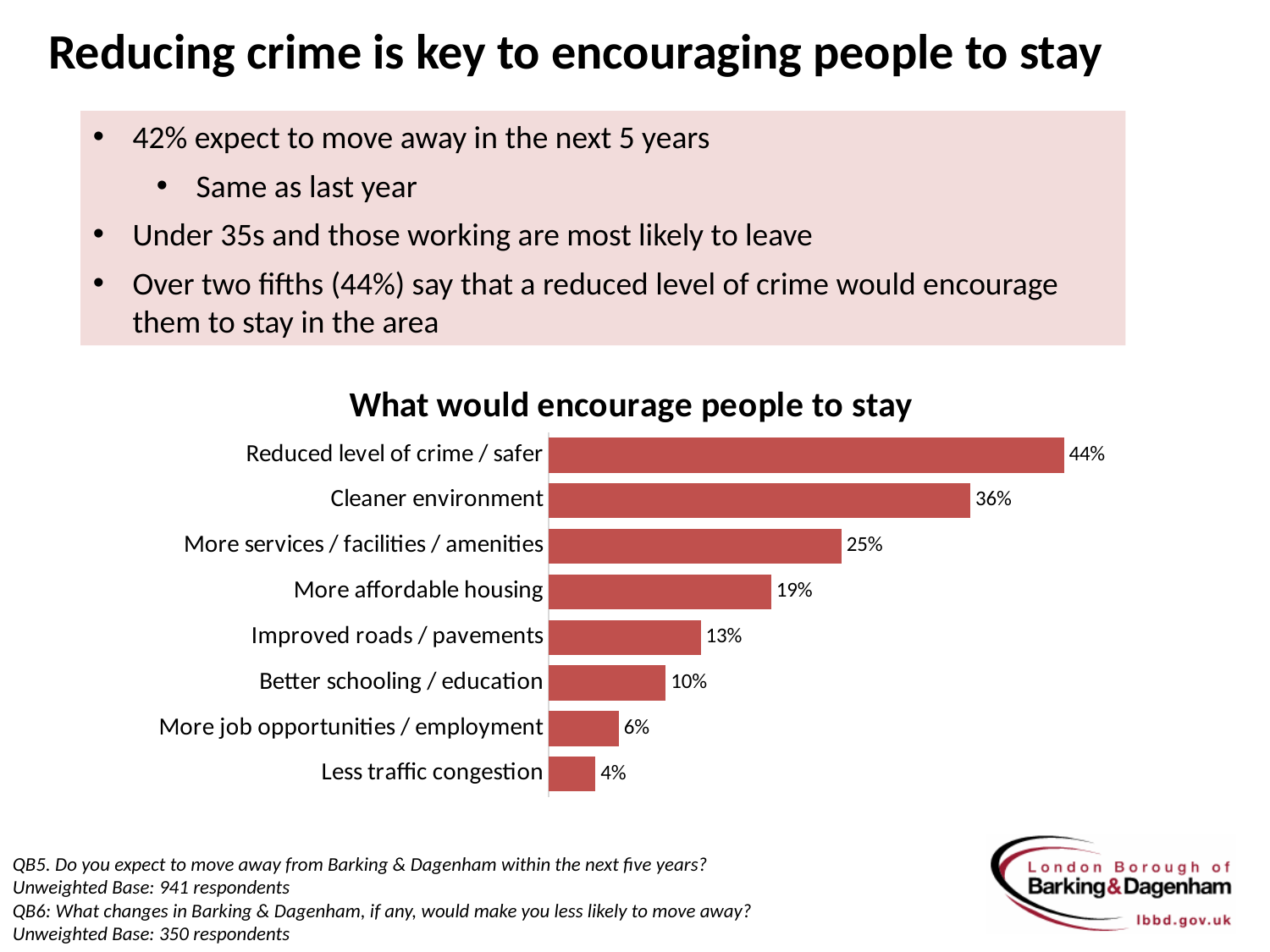
What kind of chart is shown on the slide? Bar chart What is the difference between the values for Cleaner environment and More services / facilities / amenities? 11% Which is larger: the value for Improved roads / pavements or the value for More job opportunities / employment? Improved roads / pavements What is the title of the chart? What would encourage people to stay How many categories are shown in the chart? 8 What is the value shown for More affordable housing? 19% What percentage of respondents said a reduced level of crime / safer would encourage them to stay? 44% Which category has the highest value in the chart? Reduced level of crime / safer What is the value shown for Cleaner environment? 36% Which category has the lowest value in the chart? Less traffic congestion What is the value shown for Better schooling / education? 10% What is the difference between the highest and lowest values in the chart? 40%